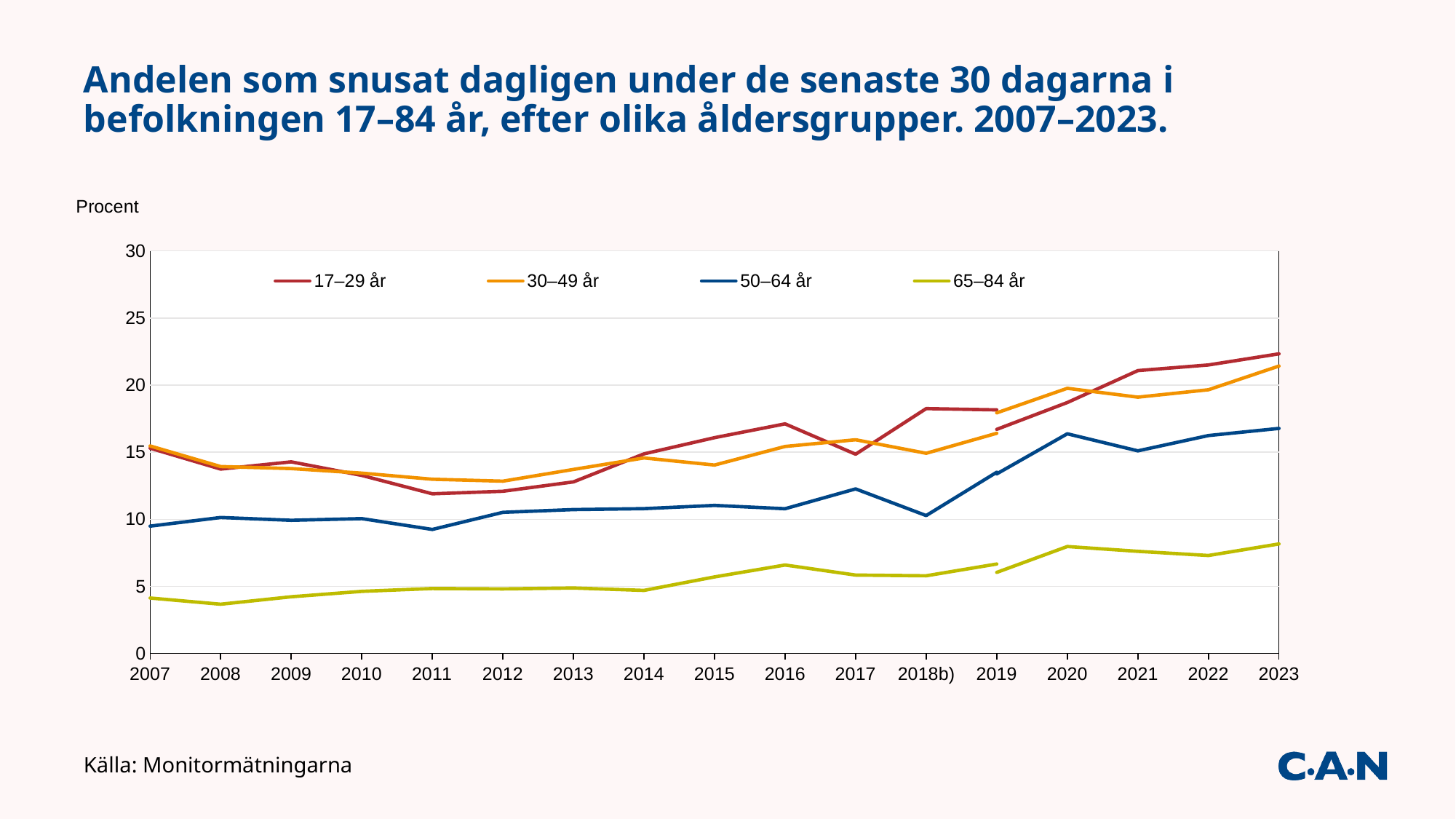
Is the value for 65–84 år in 2008 greater or less than 5? less In 2023, which is larger: the value for 30–49 år or the value for 50–64 år? 30–49 år Is the value for 50–64 år in 2020 greater or less than 15? greater Which age group has the lowest value in 2023? 65–84 år How many series does the legend list? 4 Does the value for 65–84 år rise or fall from 2007 to 2023? rise Is the value for 65–84 år in 2023 greater or less than 10? less What kind of chart is shown on the slide? line chart Which age group has the highest value in 2023? 17–29 år What is the label on the y axis? Procent How many years are shown along the x axis? 17